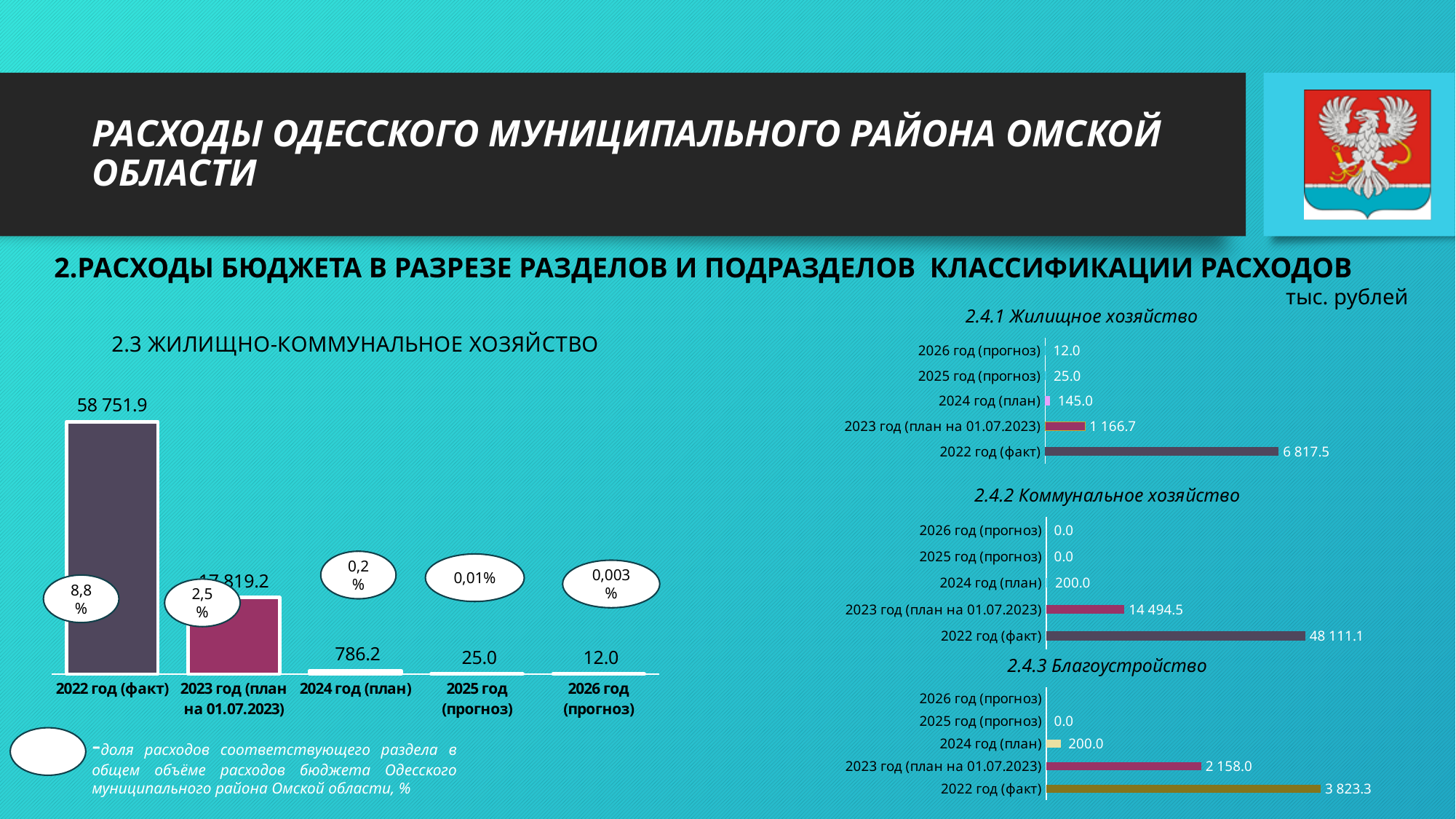
In the chart '2.3 Жилищно-коммунальное хозяйство', what is the value for 2024 год (план)? 786.2 In the chart '2.4.3 Благоустройство', what is the value for 2022 год (факт)? 3 823.3 In the chart '2.4.3 Благоустройство', which is larger: 2023 год (план на 01.07.2023) or 2024 год (план)? 2023 год (план на 01.07.2023) In the chart '2.4.2 Коммунальное хозяйство', which category has the highest value? 2022 год (факт) In the chart '2.4.1 Жилищное хозяйство', what is the value for 2024 год (план)? 145.0 In the chart '2.3 Жилищно-коммунальное хозяйство', which category has the highest value? 2022 год (факт) In the chart '2.3 Жилищно-коммунальное хозяйство', what kind of chart is shown? bar chart In the chart '2.4.2 Коммунальное хозяйство', what is the value for 2023 год (план на 01.07.2023)? 14 494.5 In the chart '2.4.1 Жилищное хозяйство', what is the value for 2022 год (факт)? 6 817.5 In the chart '2.3 Жилищно-коммунальное хозяйство', how many categories are shown on the x axis? 5 In the chart '2.4.1 Жилищное хозяйство', what is the difference between 2022 год (факт) and 2023 год (план на 01.07.2023)? 5 650.8 In the chart '2.3 Жилищно-коммунальное хозяйство', what is the value for 2022 год (факт)? 58 751.9